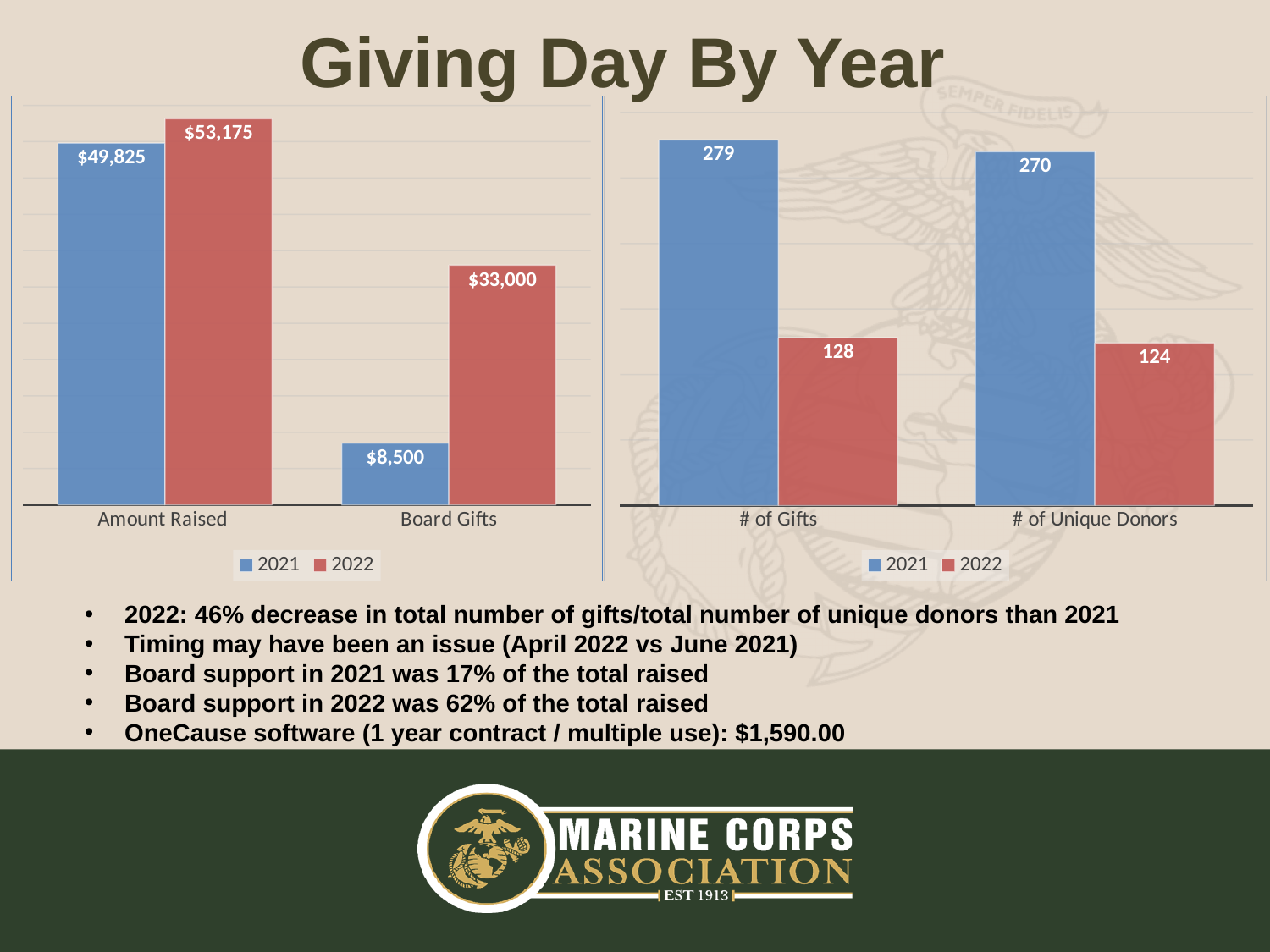
How many series does the legend of the right chart list? 2 In the right chart, what was the # of Unique Donors in 2022? 124 In the left chart, which year had the higher value for Board Gifts? 2022 In the right chart, which year had more unique donors? 2021 In the left chart, what was the value of Board Gifts in 2022? $33,000 In the right chart, what is the difference between the 2021 and 2022 # of Gifts? 151 In the right chart, what was the # of Gifts in 2021? 279 In the left chart, what was the Amount Raised in 2021? $49,825 In the left chart, what is the difference between the 2022 and 2021 Amount Raised? $3,350 What type of chart is the left chart? Bar chart In the right chart, which bar has the highest value? # of Gifts in 2021 In the left chart, which bar has the lowest value? Board Gifts in 2021